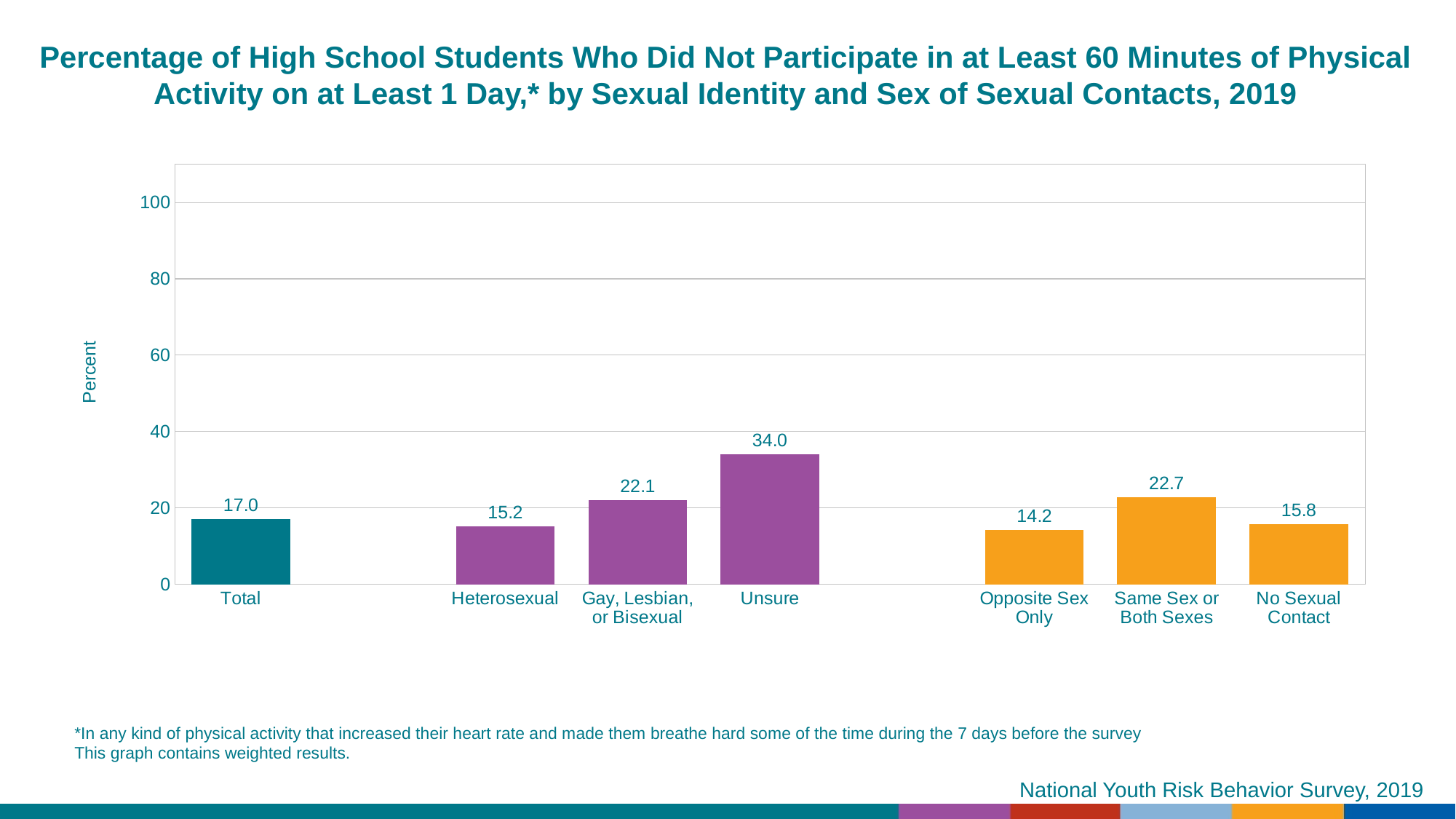
How many categories are shown on the x axis? 7 Which category has the lowest value? Opposite Sex Only Which is larger, the value for Gay, Lesbian, or Bisexual or the value for Same Sex or Both Sexes? Same Sex or Both Sexes What is the value for Unsure? 34.0 What is the label of the y axis? Percent What is the value for Total? 17.0 What kind of chart is this? bar chart What is the value for Same Sex or Both Sexes? 22.7 Which category has the highest value? Unsure Is the value for Unsure greater or less than 40? less What is the difference between the values for Unsure and Heterosexual? 18.8 What is the value for Opposite Sex Only? 14.2